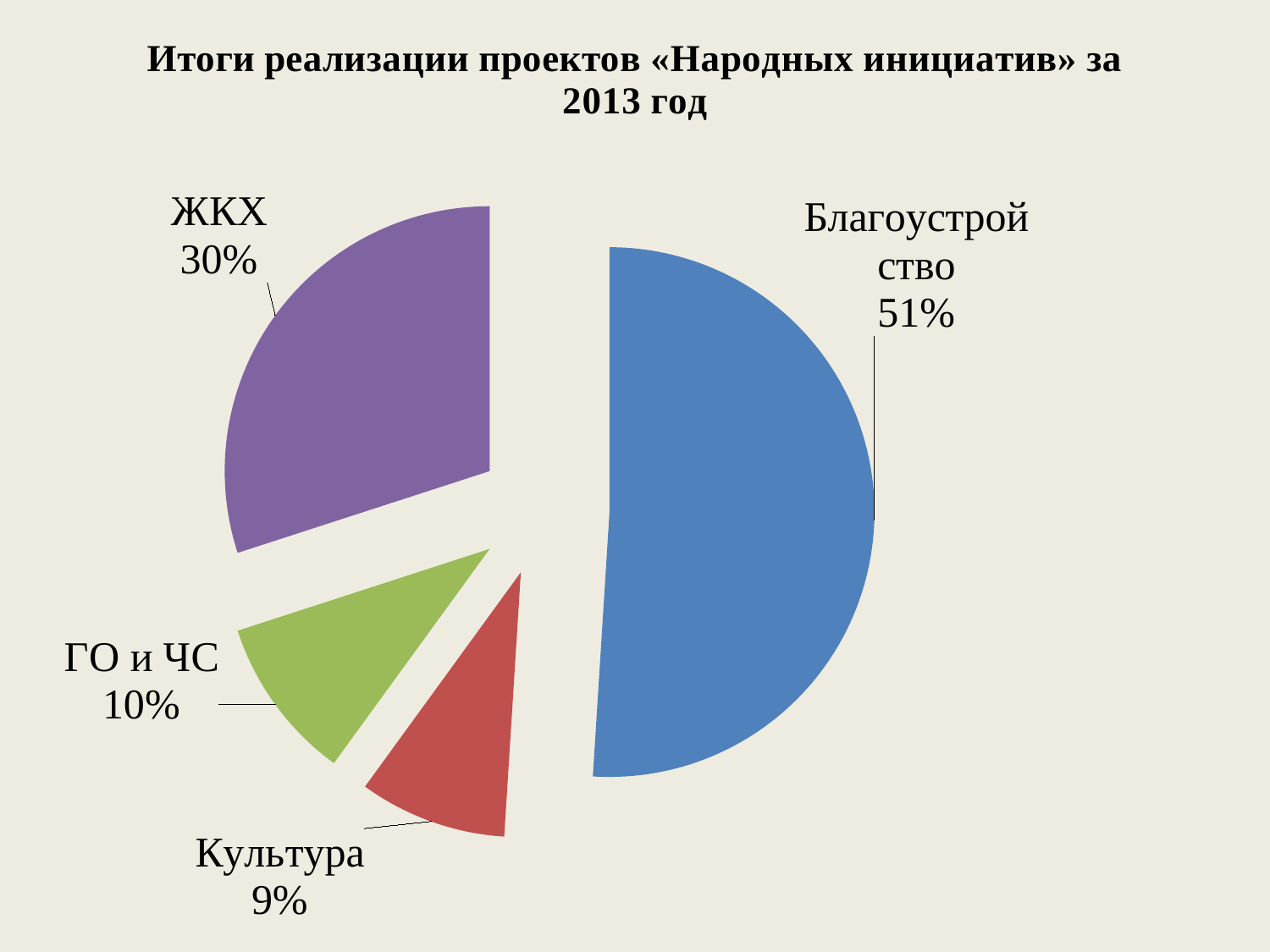
What colour is the slice for Благоустройство? blue What share of the pie does Культура have? 9% How many categories are shown in the pie chart? 4 What kind of chart is shown on the slide? pie chart What share of the pie does ГО и ЧС have? 10% What is the difference in percentage points between ЖКХ and ГО и ЧС? 20 What share of the pie does Благоустройство have? 51% Which category has the largest share of the pie? Благоустройство Which category has the smallest share of the pie? Культура What is the difference in percentage points between Благоустройство and ЖКХ? 21 Which is larger, the share for ЖКХ or the share for ГО и ЧС? ЖКХ